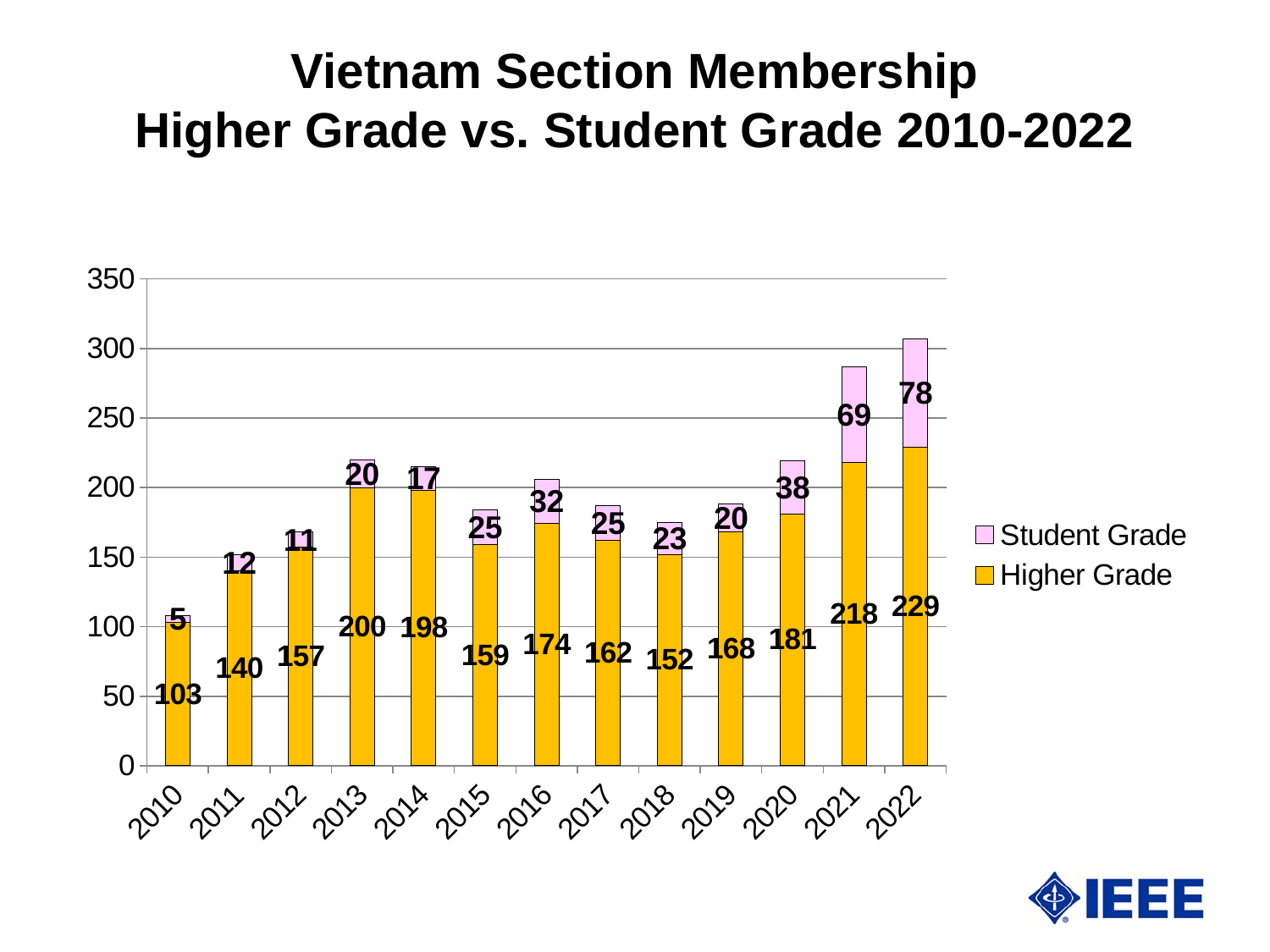
How many series does the legend list? 2 How many years are shown on the x axis? 13 Which is larger, the Higher Grade value for 2013 or for 2014? 2013 Which year has the lowest Higher Grade value? 2010 Which year has the highest Student Grade value? 2022 What is the total membership (Higher Grade plus Student Grade) for 2022? 307 What kind of chart is shown on the slide? Stacked bar chart What is the total membership (Higher Grade plus Student Grade) for 2021? 287 What is the difference between the Higher Grade values for 2022 and 2021? 11 What is the Higher Grade value for 2022? 229 What is the Higher Grade value for 2010? 103 What is the Student Grade value for 2016? 32